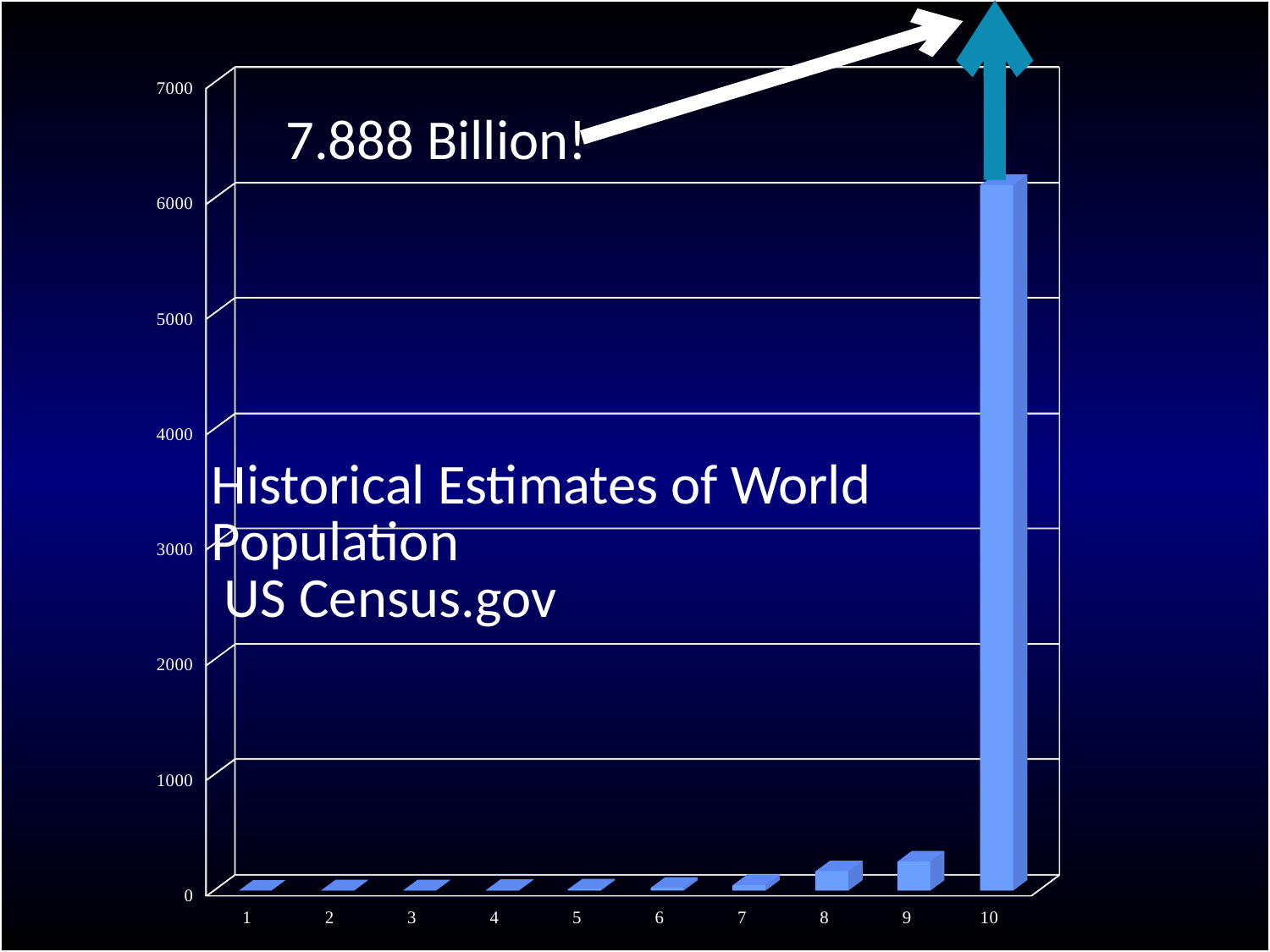
Which is larger, the value for category 9 or the value for category 8? 9 Which is larger, the value for category 10 or the value for category 9? 10 Is the value for category 9 greater or less than 1000? less What is the highest tick value shown on the y axis? 7000 How many categories are plotted along the x axis? 10 Do the values generally rise or fall from category 1 to category 10? rise Which category has the highest bar? 10 What figure is written in the annotation at the top of the chart? 7.888 Billion! What kind of chart is shown on the slide? bar chart Is the value for category 10 greater or less than 5000? greater Is the value for category 8 greater or less than 1000? less